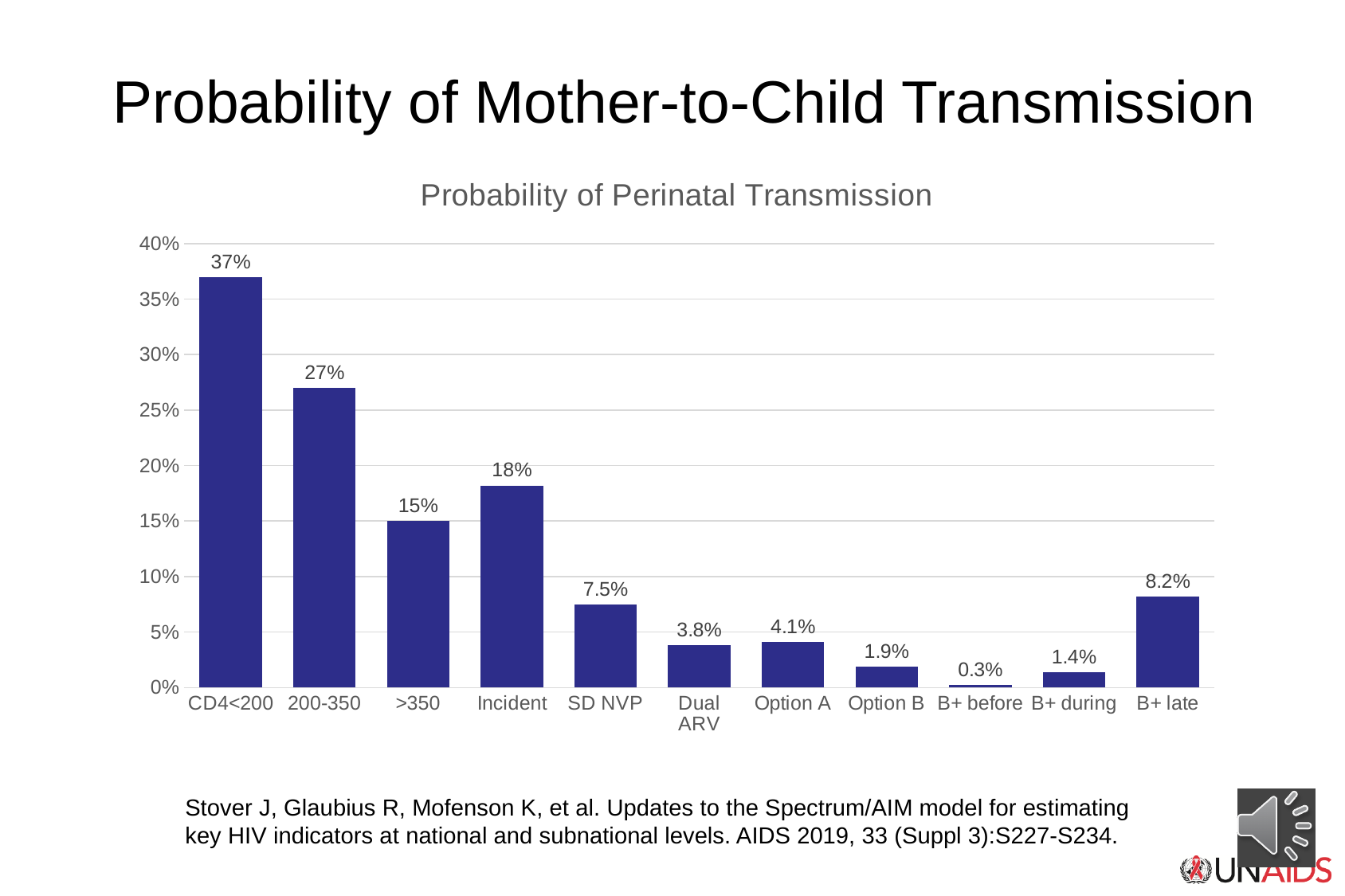
Which category has the lowest probability of perinatal transmission? B+ before How many categories are shown on the x axis? 11 What is the value shown for Option B? 1.9% What is the title of the chart? Probability of Perinatal Transmission What is the probability of perinatal transmission for CD4<200? 37% Which is larger, the value for Option A or the value for Dual ARV? Option A Which category has the highest probability of perinatal transmission? CD4<200 What is the difference between the values for 200-350 and >350? 12% What is the difference between the values for SD NVP and Dual ARV? 3.7% What kind of chart is shown on the slide? bar chart Is the value for Incident greater or less than 20%? less What is the value shown for B+ late? 8.2%